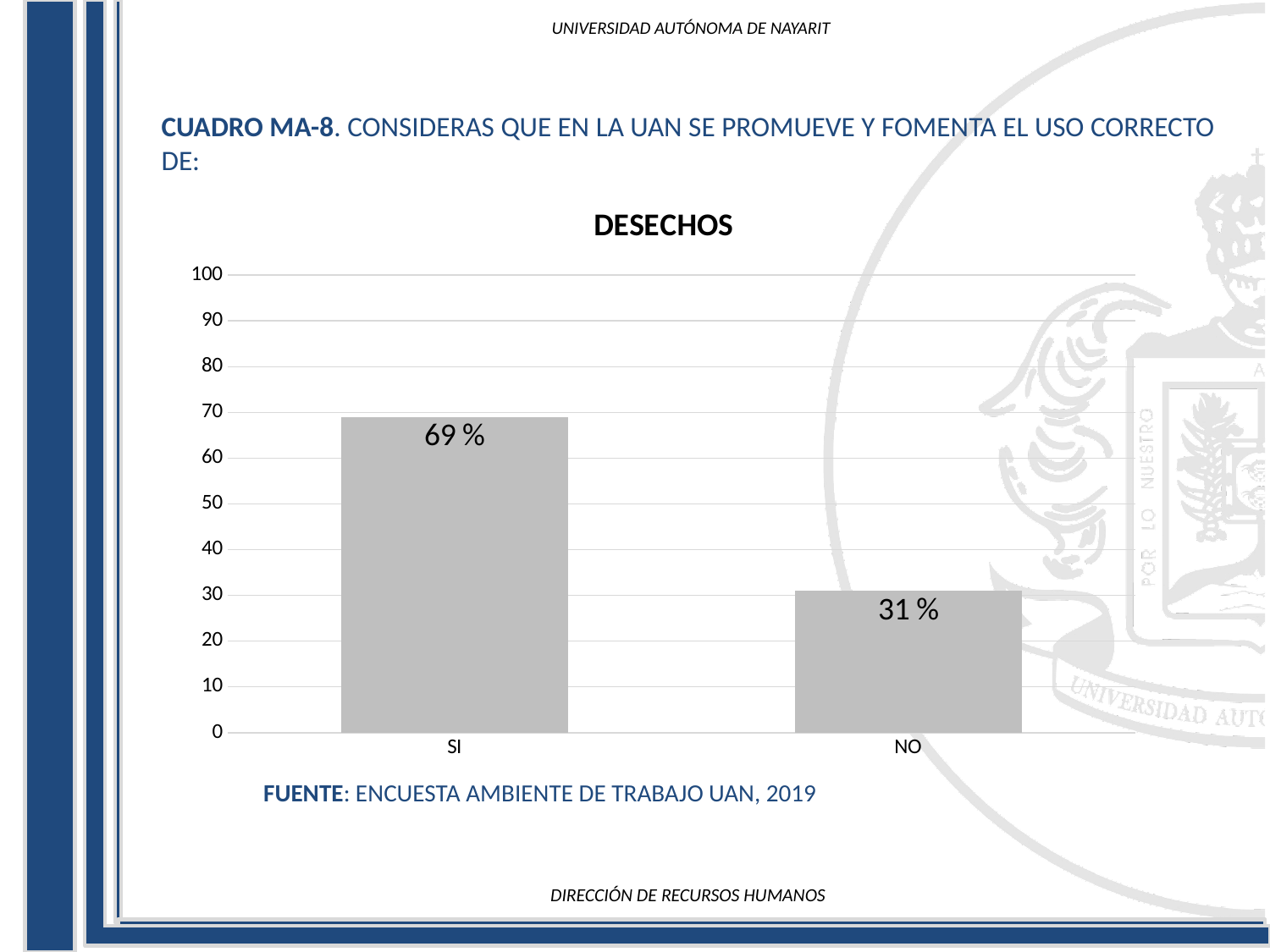
What is the title of the chart on the slide? DESECHOS What is the maximum value shown on the vertical axis of the DESECHOS chart? 100 Is the value for SI in the DESECHOS chart greater or less than 60? greater Which category has the lowest value in the DESECHOS chart? NO What is the value for NO in the DESECHOS chart? 31 % How many categories are shown in the DESECHOS chart? 2 Is the value for NO in the DESECHOS chart greater or less than 40? less Which is larger in the DESECHOS chart, the value for SI or the value for NO? SI Which category has the highest value in the DESECHOS chart? SI What is the difference between the values for SI and NO in the DESECHOS chart? 38 % What kind of chart is the DESECHOS chart? bar chart What is the value for SI in the DESECHOS chart? 69 %